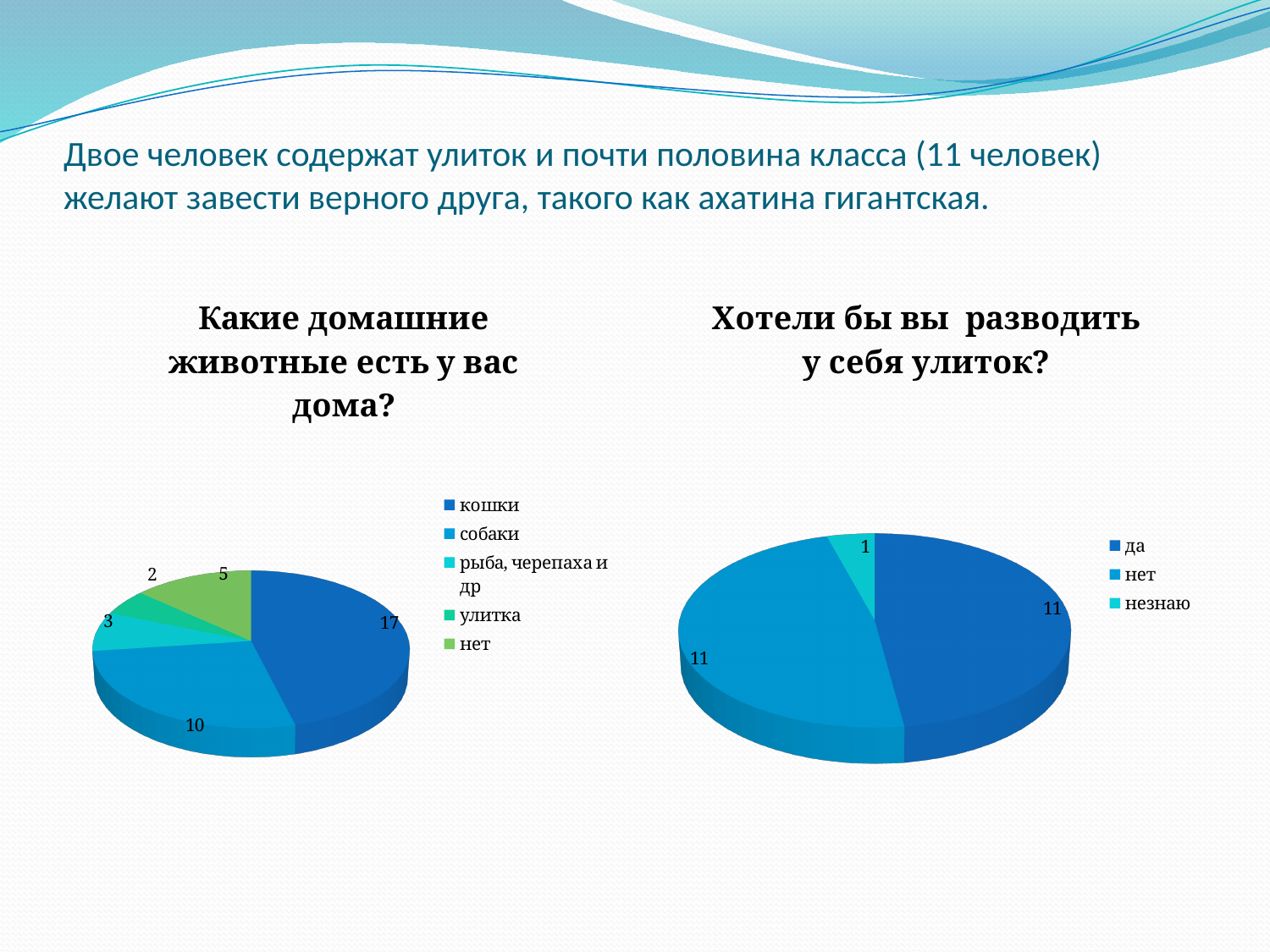
In the left chart 'Какие домашние животные есть у вас дома?', which category has the largest slice? кошки In the left chart 'Какие домашние животные есть у вас дома?', which category has the smallest slice? улитка In the left chart 'Какие домашние животные есть у вас дома?', what is the value for улитка? 2 In the left chart 'Какие домашние животные есть у вас дома?', what is the difference between the values for кошки and собаки? 7 In the right chart 'Хотели бы вы разводить у себя улиток?', what is the value for да? 11 In the left chart 'Какие домашние животные есть у вас дома?', what is the value for собаки? 10 In the right chart 'Хотели бы вы разводить у себя улиток?', which category has the smallest slice? незнаю In the right chart 'Хотели бы вы разводить у себя улиток?', what is the value for незнаю? 1 In the left chart 'Какие домашние животные есть у вас дома?', what is the value for кошки? 17 What type of chart is the right chart 'Хотели бы вы разводить у себя улиток?'? pie chart In the left chart 'Какие домашние животные есть у вас дома?', how many categories does the legend list? 5 In the right chart 'Хотели бы вы разводить у себя улиток?', what is the total of all slices? 23